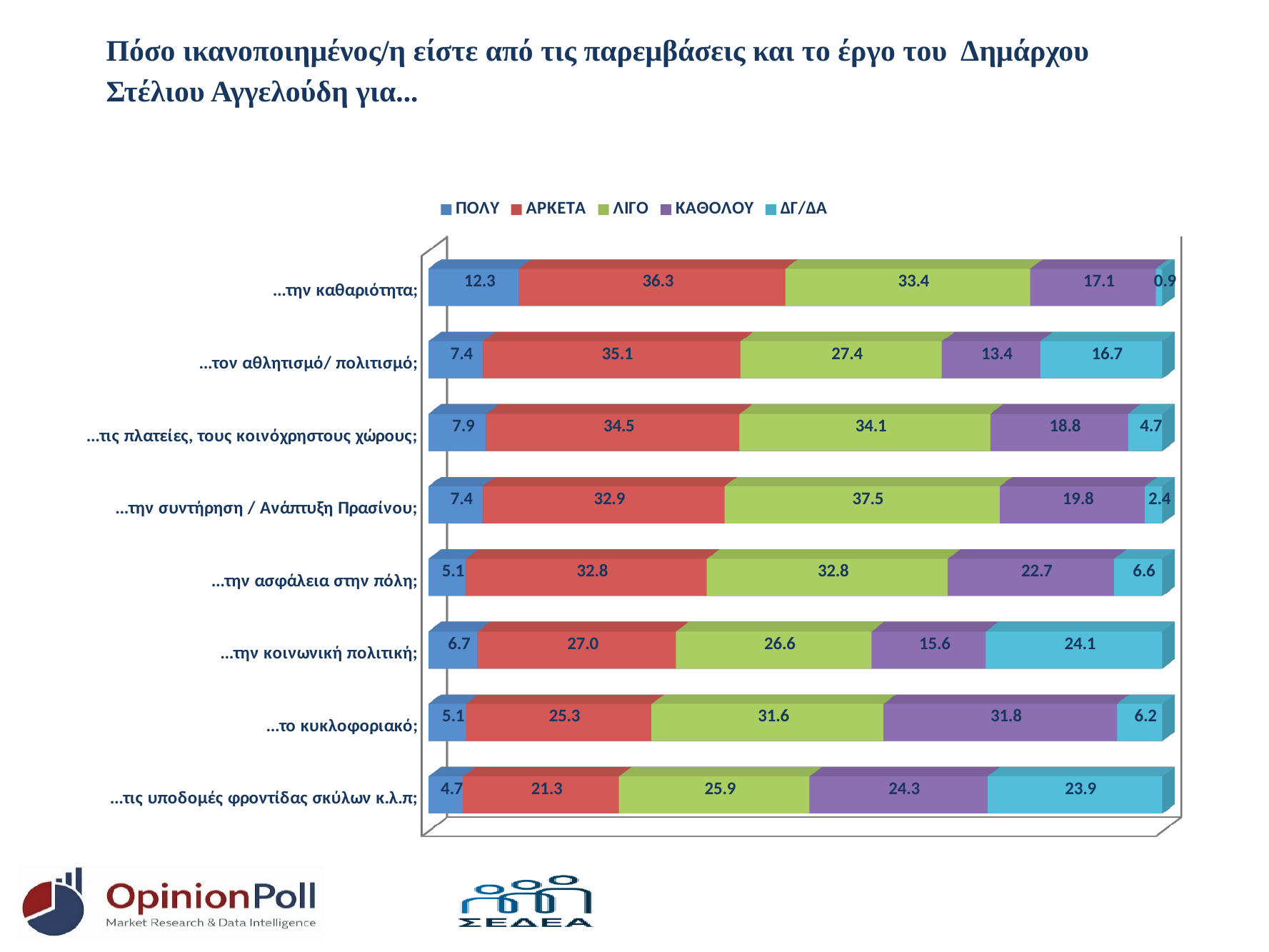
What kind of chart is shown on the slide? Stacked bar chart What is the ΑΡΚΕΤΑ value for "...την καθαριότητα;"? 36.3 Which category has the highest ΠΟΛΥ value? ...την καθαριότητα; What is the total of the stacked bar for "...την καθαριότητα;"? 100.0 How many series does the legend list? 5 Which category has the lowest ΔΓ/ΔΑ value? ...την καθαριότητα; What is the difference between the ΑΡΚΕΤΑ value for "...την καθαριότητα;" and the ΑΡΚΕΤΑ value for "...τις υποδομές φροντίδας σκύλων κ.λ.π;"? 15.0 How many categories are shown in the chart? 8 What is the ΔΓ/ΔΑ value for "...την κοινωνική πολιτική;"? 24.1 Which category has the highest ΚΑΘΟΛΟΥ value? ...το κυκλοφοριακό; What is the ΚΑΘΟΛΟΥ value for "...το κυκλοφοριακό;"? 31.8 Which is larger: the ΛΙΓΟ value for "...την συντήρηση / Ανάπτυξη Πρασίνου;" or the ΛΙΓΟ value for "...τις πλατείες, τους κοινόχρηστους χώρους;"? ...την συντήρηση / Ανάπτυξη Πρασίνου;